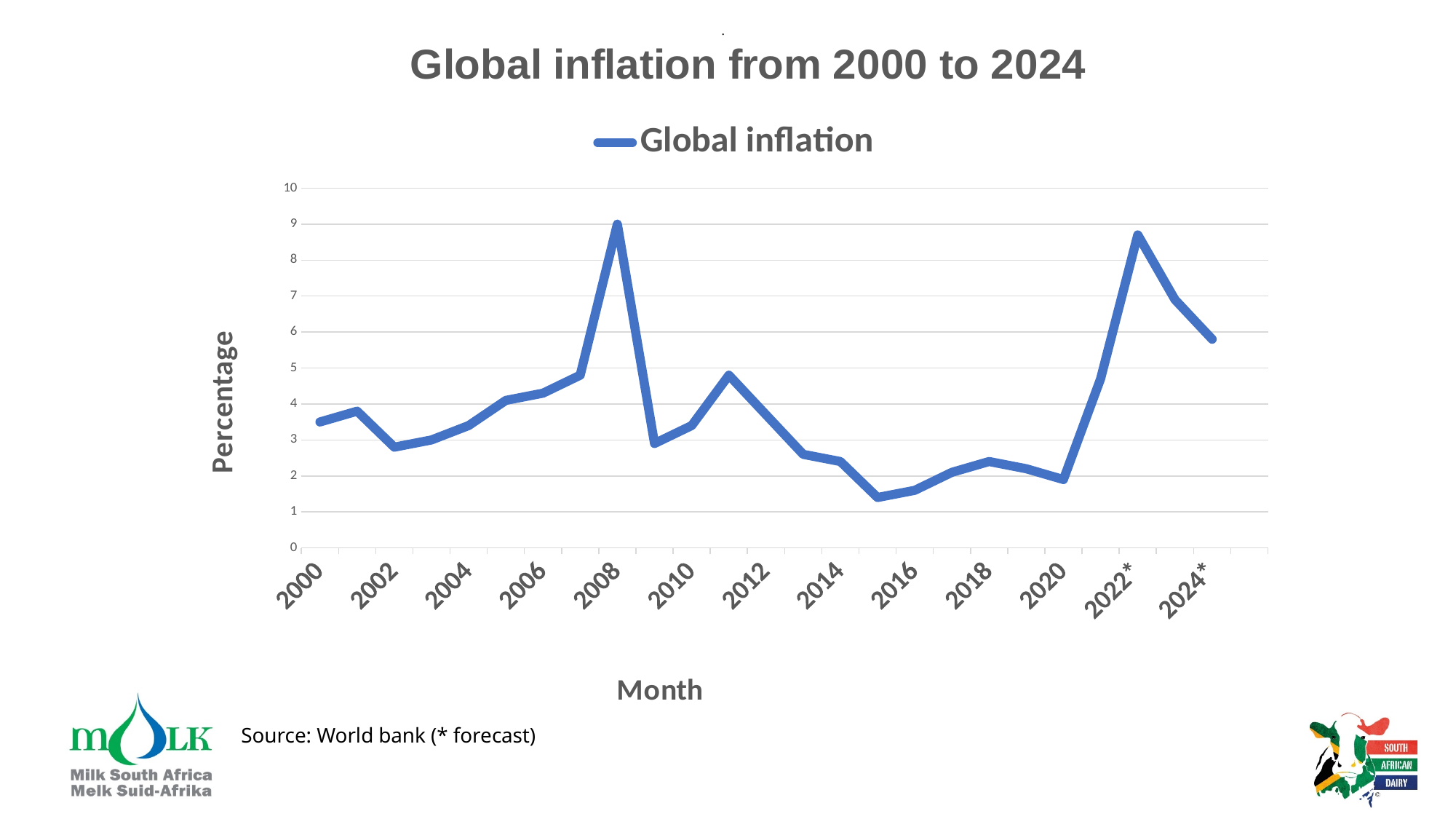
What kind of chart is shown on the slide? line chart How many series does the legend list? 1 What is the title of the chart? Global inflation from 2000 to 2024 In which year does global inflation reach its highest value? 2008 Is the value for 2008 greater or less than 8? greater Is the value for 2024* greater or less than 5? greater How many year labels are shown on the x axis? 13 Which year has the higher global inflation, 2011 or 2015? 2011 What is the label on the vertical axis? Percentage Is the value for 2014 greater or less than 3? less Does global inflation rise or fall from 2022* to 2024*? fall